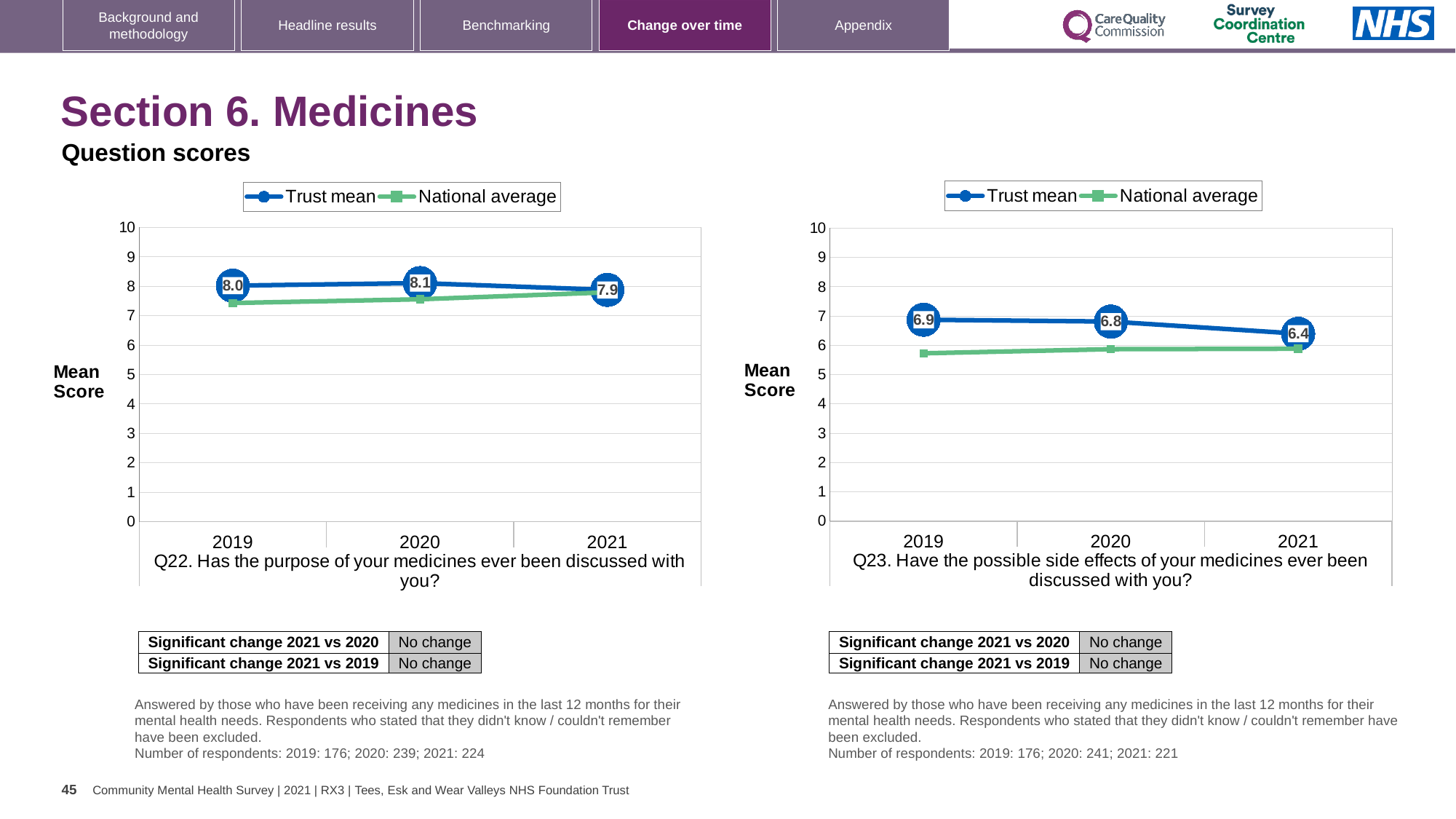
In the Q23 chart on the right, which year has the lowest Trust mean score? 2021 In the Q22 chart on the left, is the National average for 2019 greater or less than 7? greater In the Q23 chart on the right, is the National average for 2019 greater or less than 6? less In the Q23 chart on the right, what is the Trust mean score for 2021? 6.4 In the Q22 chart on the left, what is the Trust mean score for 2021? 7.9 In the Q22 chart on the left, which year has the highest Trust mean score? 2020 What kind of chart is the Q23 chart on the right? Line chart In the Q22 chart on the left, what is the Trust mean score for 2020? 8.1 Is the Trust mean for 2021 higher in the Q22 chart or the Q23 chart? Q22 chart In the Q23 chart on the right, what is the Trust mean score for 2019? 6.9 How many series does the legend of the Q22 chart on the left list? 2 In the Q23 chart on the right, what is the difference between the Trust mean scores for 2019 and 2021? 0.5